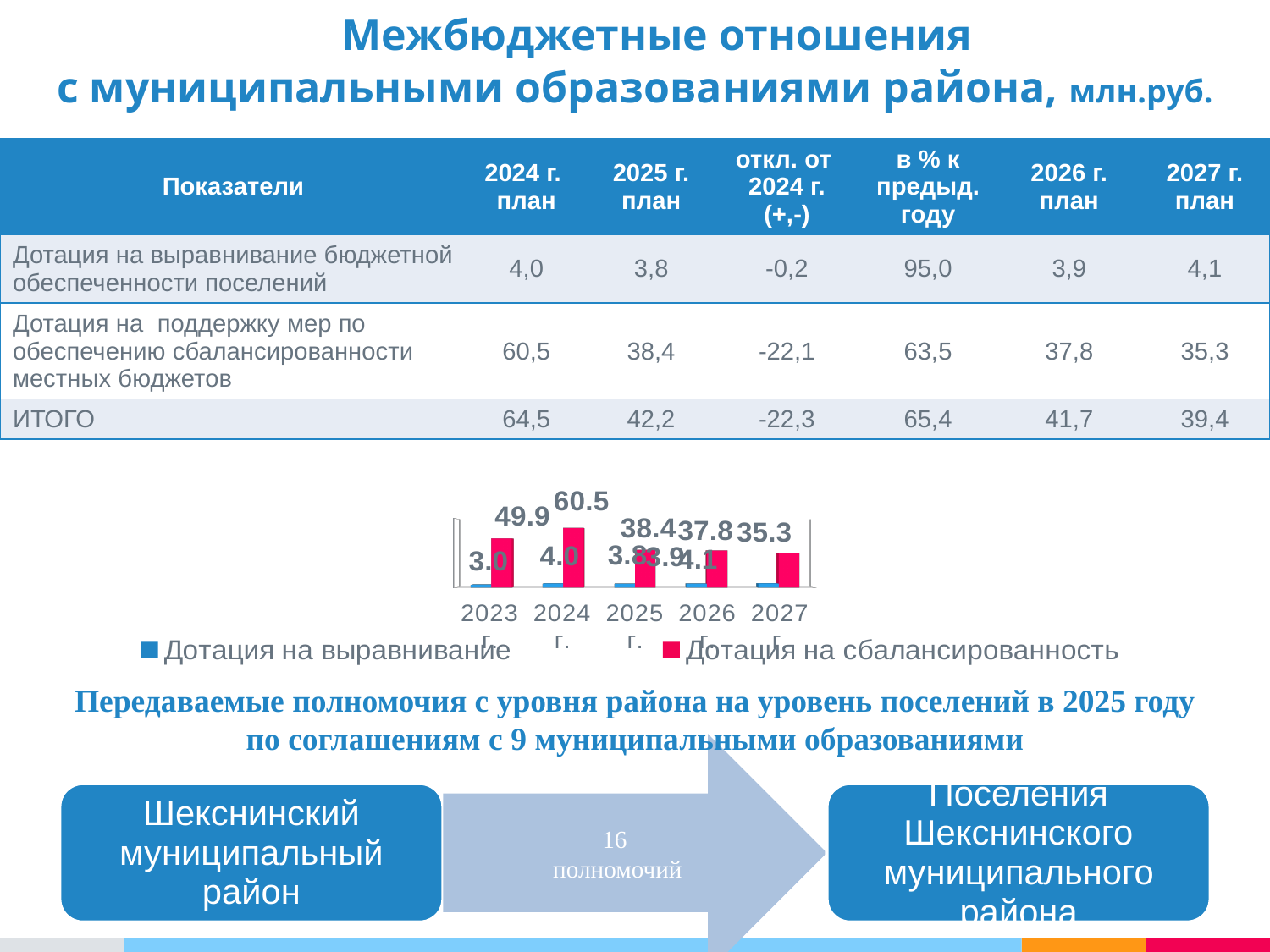
What is the value of Дотация на выравнивание for 2024 in the chart? 4.0 What is the value of Дотация на сбалансированность for 2023 in the chart? 49.9 How many series does the chart legend list? 2 What kind of chart is shown on the slide? bar chart What is the value of Дотация на выравнивание for 2023 in the chart? 3.0 In which year is Дотация на сбалансированность lowest in the chart? 2027 How many years are shown on the x axis of the chart? 5 What is the value of Дотация на сбалансированность for 2024 in the chart? 60.5 What colour represents Дотация на сбалансированность in the chart? red In which year is Дотация на сбалансированность highest in the chart? 2024 By how much does Дотация на сбалансированность in 2024 exceed the 2023 value in the chart? 10.6 Does Дотация на сбалансированность rise or fall from 2024 to 2027 in the chart? fall